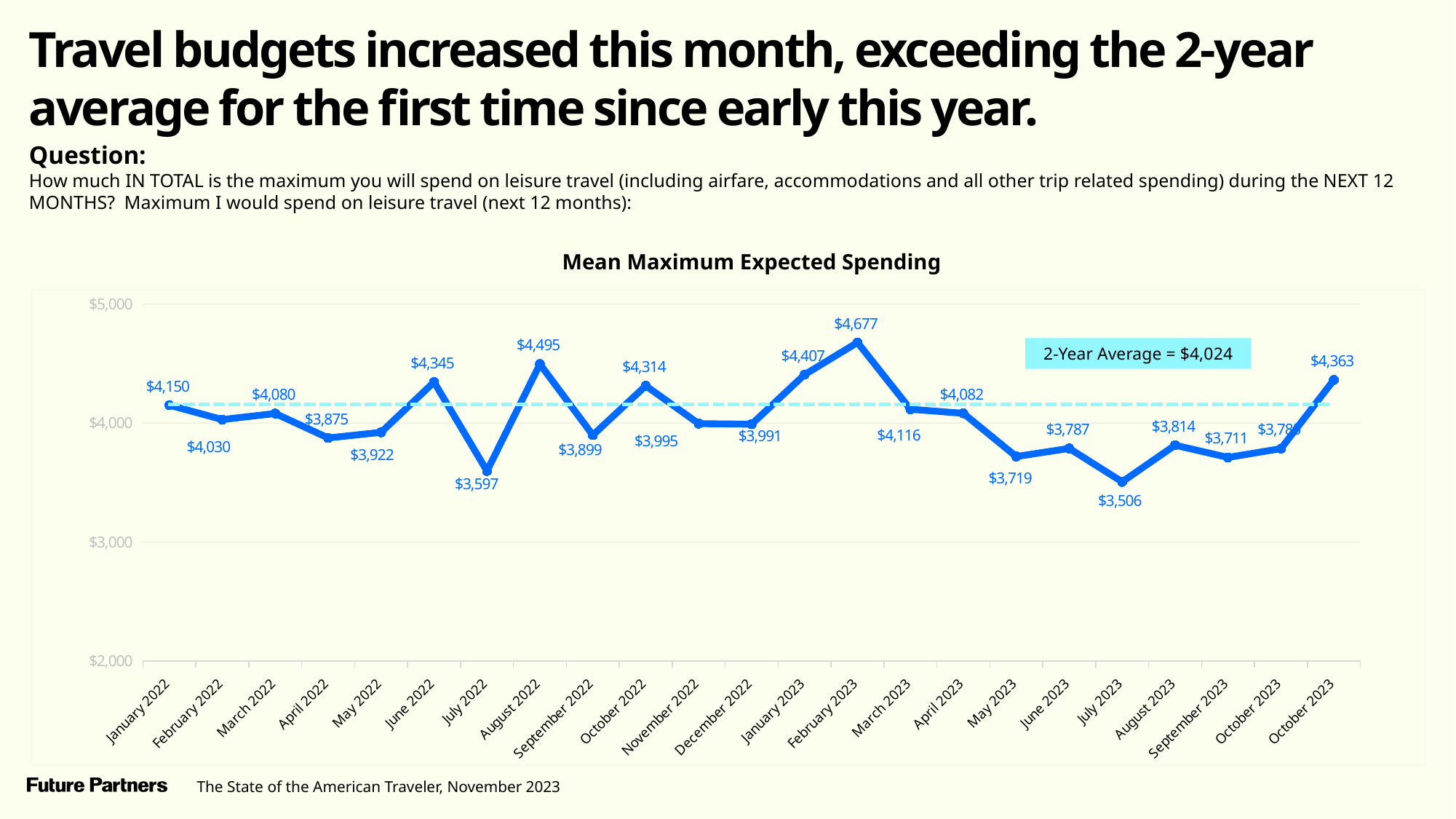
What is the mean maximum expected spending for February 2023? $4,677 What is the 2-year average shown on the chart? $4,024 Which is larger, the value for June 2022 or the value for August 2022? August 2022 What is the difference between the February 2023 value and the July 2023 value? $1,171 Which month has the highest mean maximum expected spending? February 2023 Between February 2023 and May 2023, do the values rise or fall? fall What is the difference between the January 2022 value and the February 2022 value? $120 Is the value for July 2022 greater or less than $4,000? less What is the mean maximum expected spending for May 2023? $3,719 What is the mean maximum expected spending for January 2022? $4,150 What kind of chart is shown on the slide? line chart Which month has the lowest mean maximum expected spending? July 2023